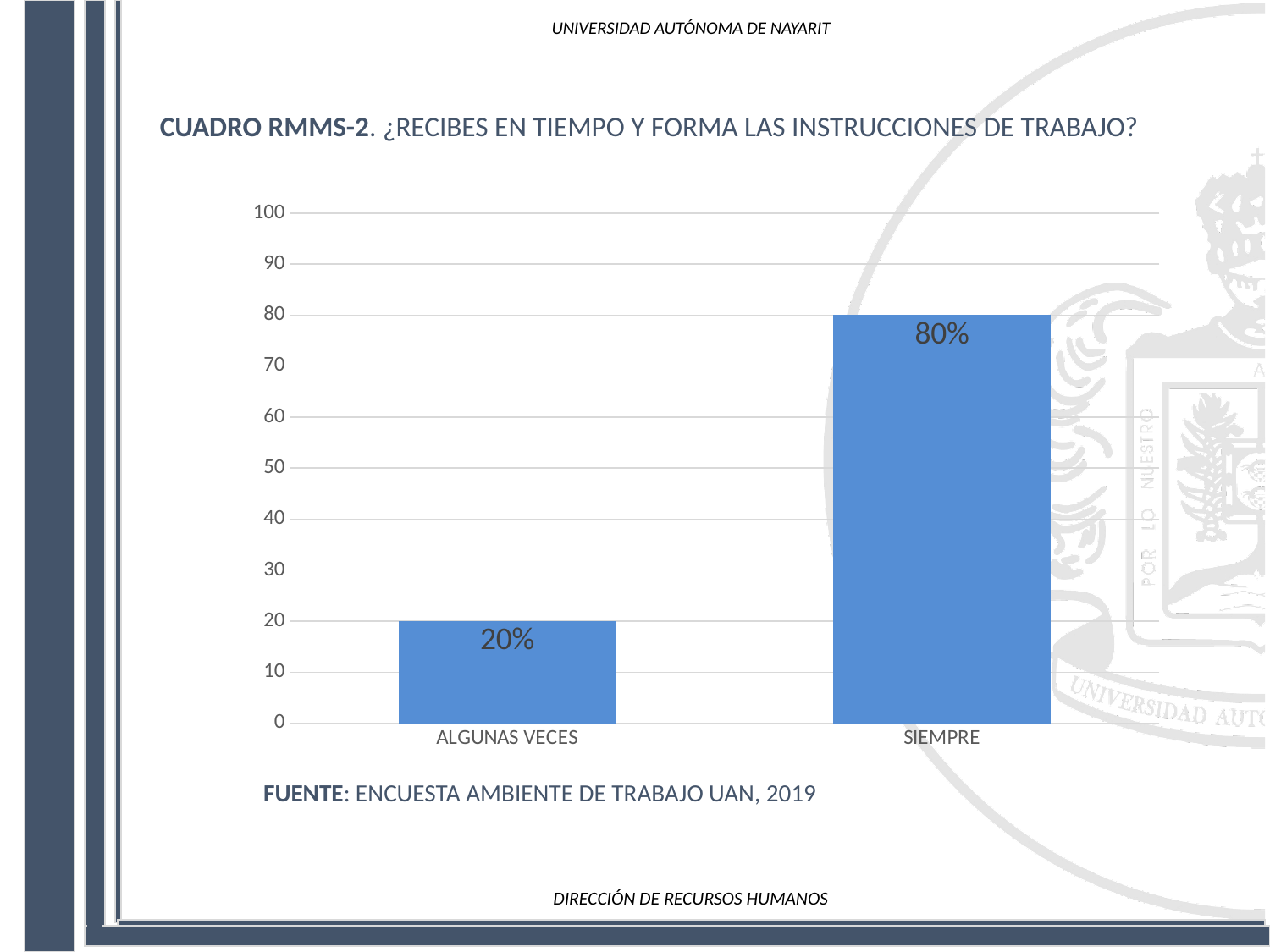
What is the highest value shown on the y axis? 100 What is the difference between the values for SIEMPRE and ALGUNAS VECES? 60% Which category has the lowest value? ALGUNAS VECES What is the value for ALGUNAS VECES? 20% Which is larger, the value for ALGUNAS VECES or the value for SIEMPRE? SIEMPRE What source is cited below the chart? ENCUESTA AMBIENTE DE TRABAJO UAN, 2019 Which category has the highest value? SIEMPRE Is the value for SIEMPRE greater or less than 50? greater What is the value for SIEMPRE? 80% Is the value for ALGUNAS VECES greater or less than 30? less How many categories are shown on the x axis? 2 What kind of chart is shown on the slide? Bar chart